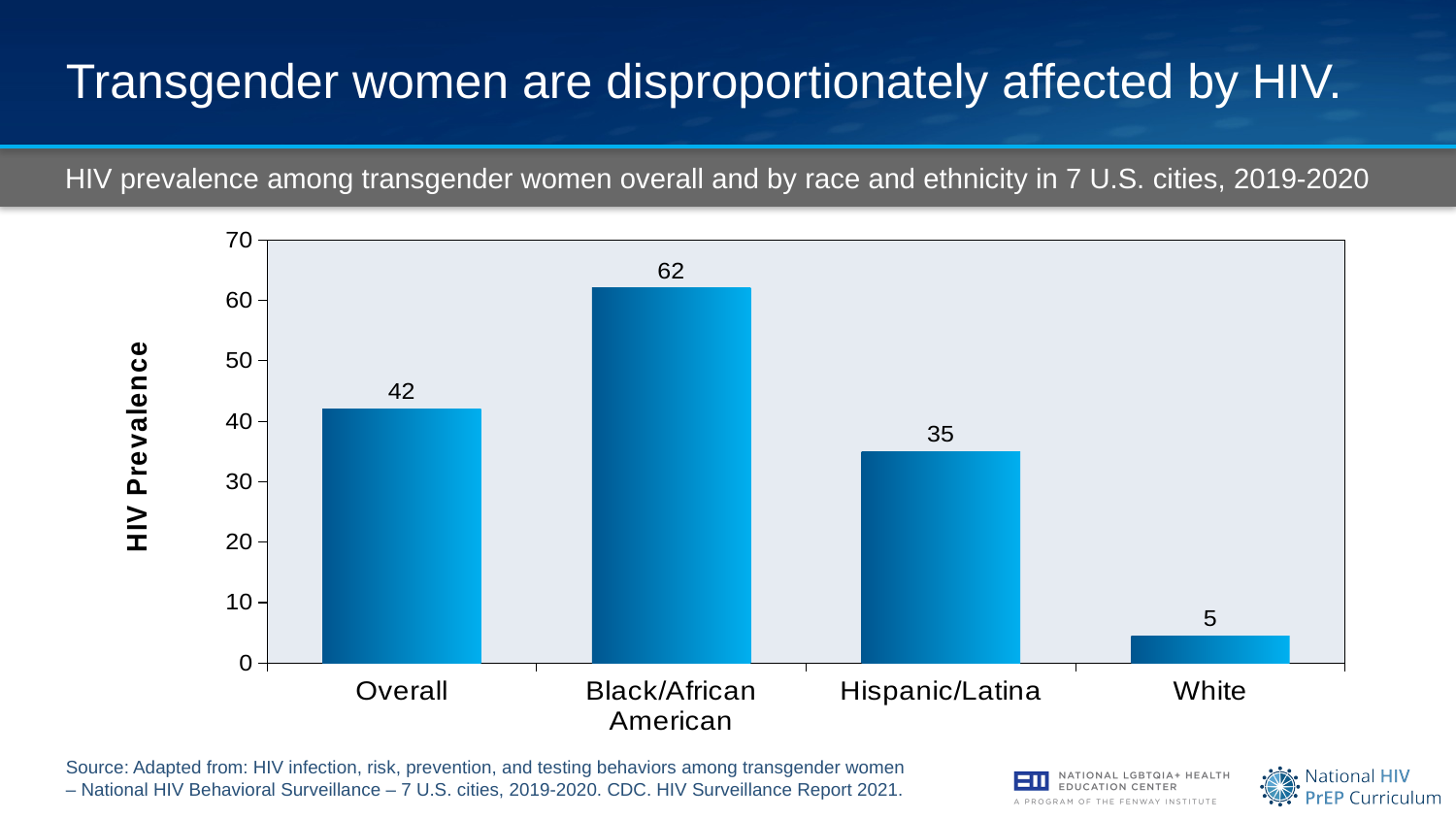
What is the HIV prevalence value for Hispanic/Latina transgender women? 35 What is the HIV prevalence value for Black/African American transgender women? 62 Which is larger, the HIV prevalence for Overall or for Hispanic/Latina? Overall Which category has the highest HIV prevalence? Black/African American What kind of chart is shown on the slide? Bar chart How many categories are shown on the x axis of the chart? 4 What is the difference between the Overall HIV prevalence and the value for White? 37 Is the value for Black/African American greater or less than 60? greater Which category has the lowest HIV prevalence? White What is the HIV prevalence value for the Overall category? 42 What is the difference between the HIV prevalence for Black/African American and Hispanic/Latina? 27 What is the HIV prevalence value for White transgender women? 5